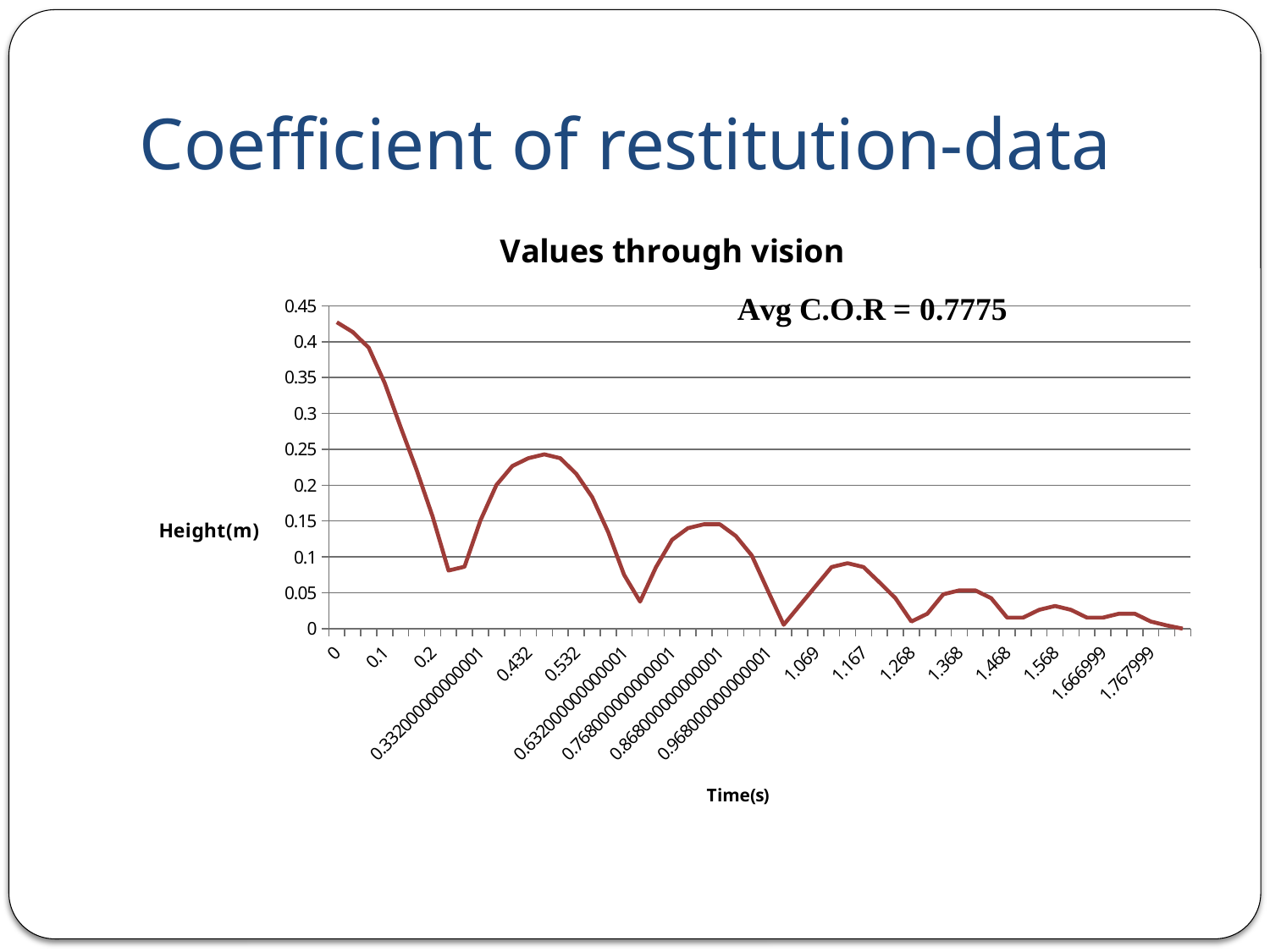
What is the title of the chart? Values through vision Is the height at time 0.532 greater or less than 0.2? greater Is the height at time 0.332000000000001 greater or less than 0.1? greater Overall, do the peak heights rise or fall as time increases along the x axis? fall What kind of chart is shown on the slide? line chart Which is larger: the height at time 0 or the height at time 0.432? time 0 Is the height at time 0 greater or less than 0.4? greater At which time value does the line reach its highest height? 0 What average coefficient of restitution is stated on the chart? Avg C.O.R = 0.7775